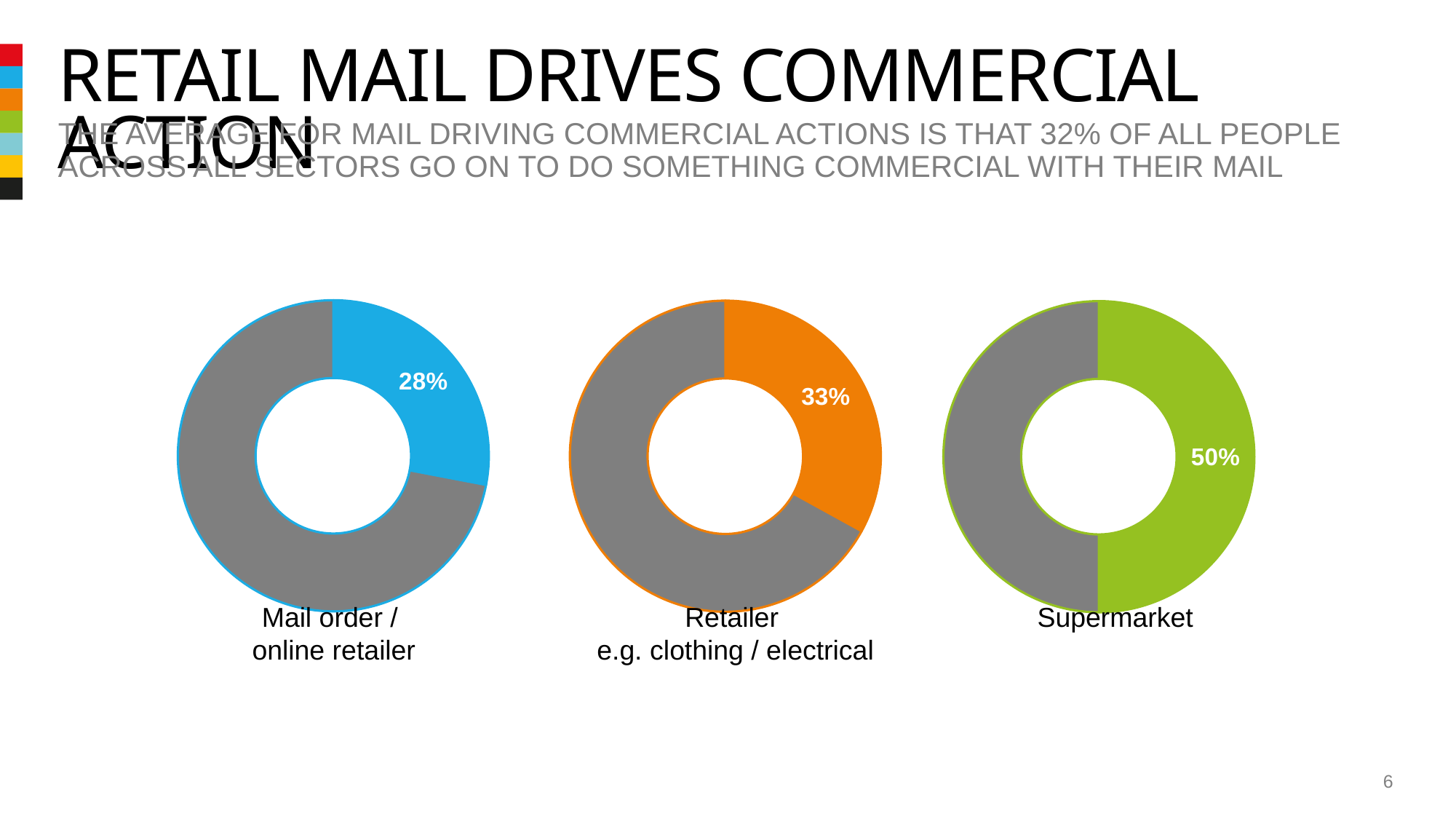
Across the three donut charts, which sector has the highest labelled percentage? Supermarket What colour is the highlighted segment in the Retailer e.g. clothing / electrical chart? Orange In the Retailer e.g. clothing / electrical chart, what percentage is shown for the highlighted (orange) segment? 33% Which is larger: the labelled percentage for Retailer e.g. clothing / electrical or for Mail order / online retailer? Retailer e.g. clothing / electrical In the Supermarket chart, what share of the ring does the grey segment represent? 50% Across the three donut charts, which sector has the lowest labelled percentage? Mail order / online retailer What is the difference between the Retailer e.g. clothing / electrical percentage and the Mail order / online retailer percentage? 5% What kind of chart is used to show the Supermarket figure? Donut (pie) chart What is the difference between the Supermarket percentage and the Mail order / online retailer percentage? 22% In the Mail order / online retailer chart, what percentage is shown for the highlighted (blue) segment? 28% In the Supermarket chart, what percentage is shown for the highlighted (green) segment? 50% How many donut charts are shown on the slide? 3